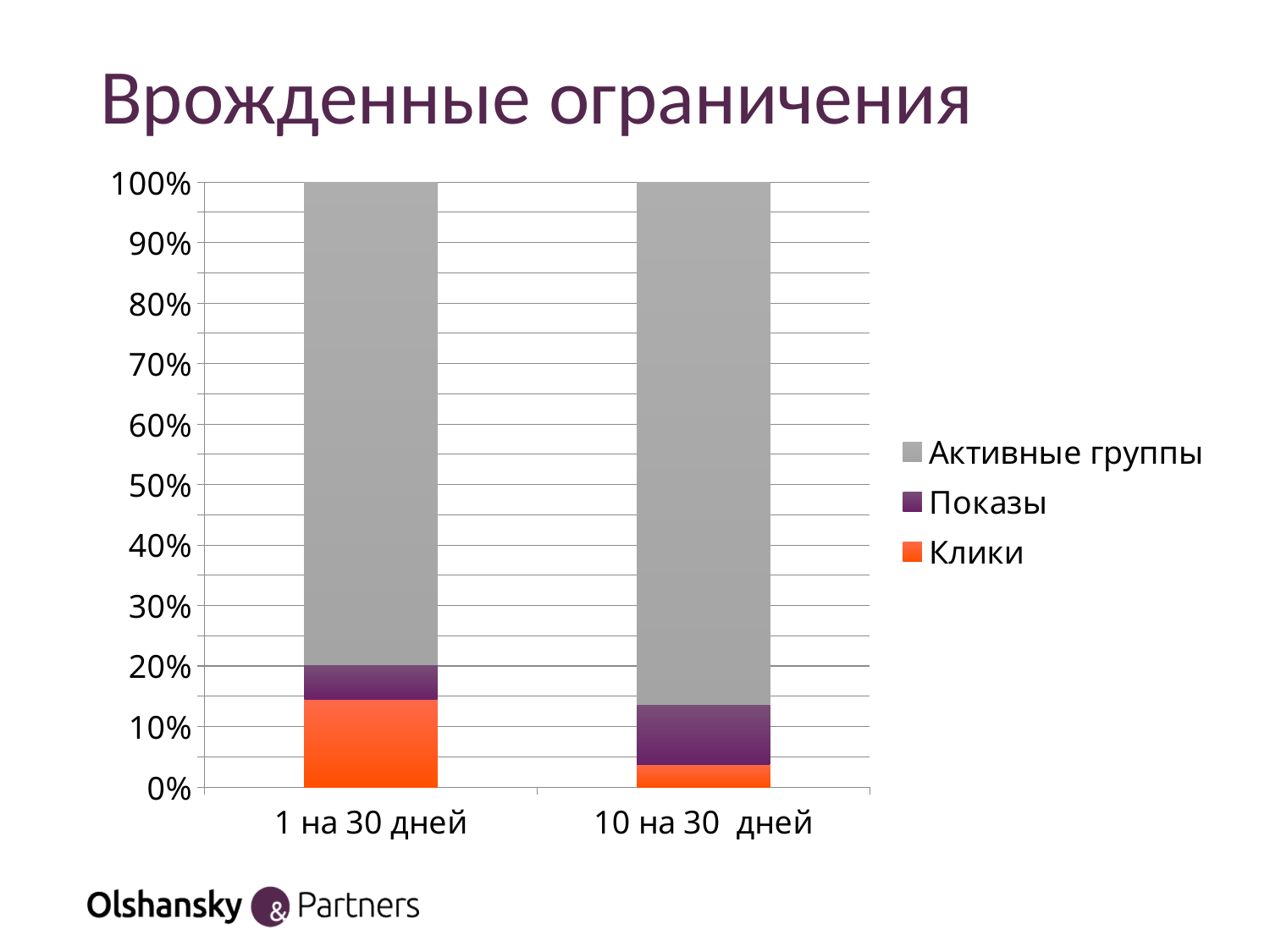
Which series is shown in orange in the legend? Клики Is the value of Клики for "1 на 30 дней" greater or less than 10%? greater What kind of chart is shown on the slide? Stacked bar chart Which category has the larger Активные группы share: "1 на 30 дней" or "10 на 30 дней"? 10 на 30 дней What is the total height of the stacked bar for "1 на 30 дней"? 100% Is the value of Активные группы for "1 на 30 дней" greater or less than 70%? greater Which category has the larger Клики share: "1 на 30 дней" or "10 на 30 дней"? 1 на 30 дней What is the title of the slide with the chart? Врожденные ограничения How many series does the legend list? 3 Which category has the larger Показы share: "1 на 30 дней" or "10 на 30 дней"? 10 на 30 дней How many categories are shown on the x axis? 2 Is the value of Клики for "10 на 30 дней" greater or less than 10%? less